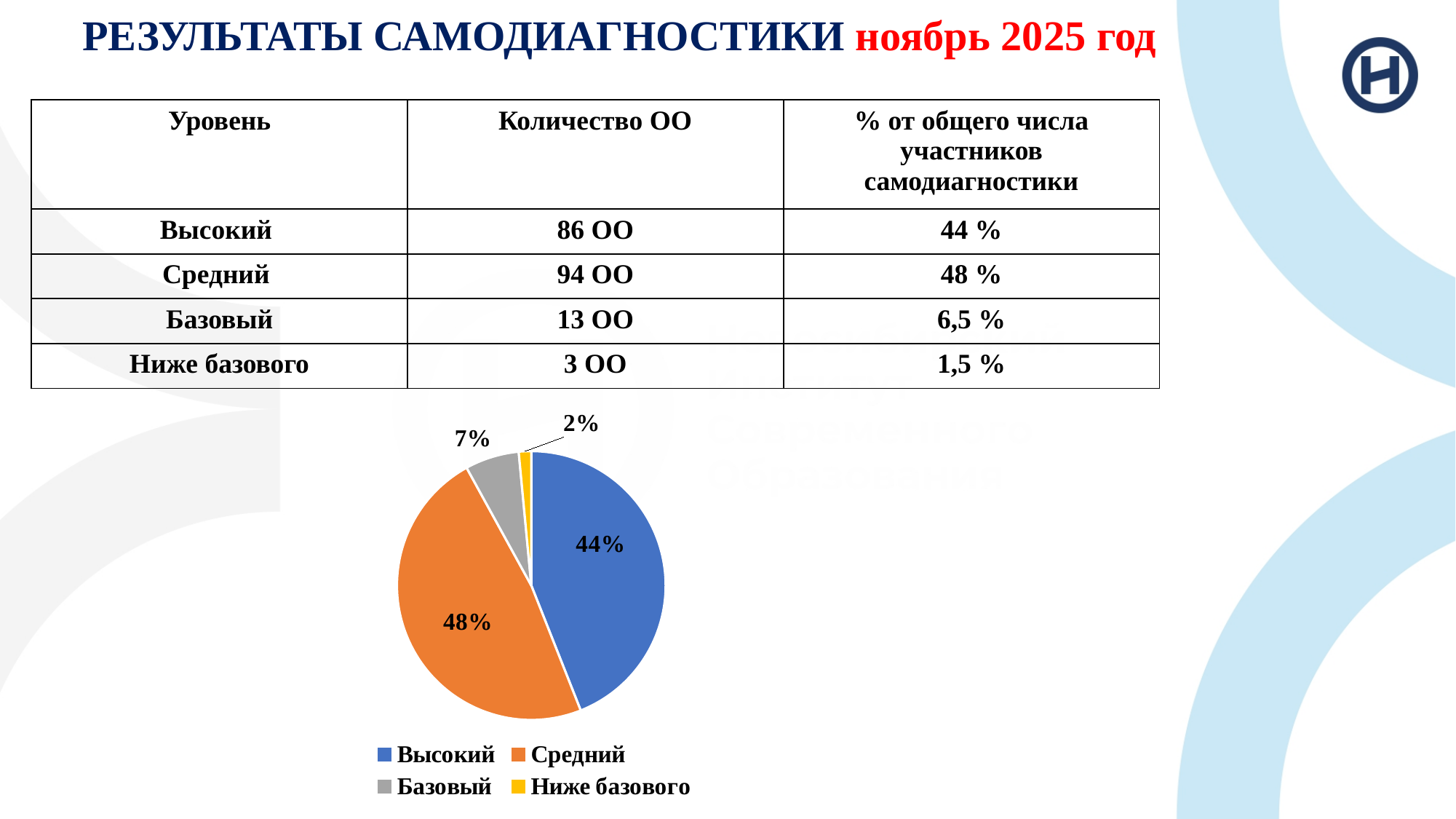
What share of the pie chart does the Ниже базового slice have? 2% What kind of chart is shown on the slide? pie chart What share of the pie chart does the Базовый slice have? 7% What share of the pie chart does the Высокий slice have? 44% What colour is the Средний slice in the pie chart? orange What is the difference in percentage points between the Средний and Высокий slices in the pie chart? 4% Which category has the smallest slice in the pie chart? Ниже базового How many categories does the pie chart legend list? 4 In the pie chart, which is larger: the Высокий slice or the Базовый slice? Высокий Which category has the largest slice in the pie chart? Средний What is the difference in percentage points between the Базовый and Ниже базового slices in the pie chart? 5%